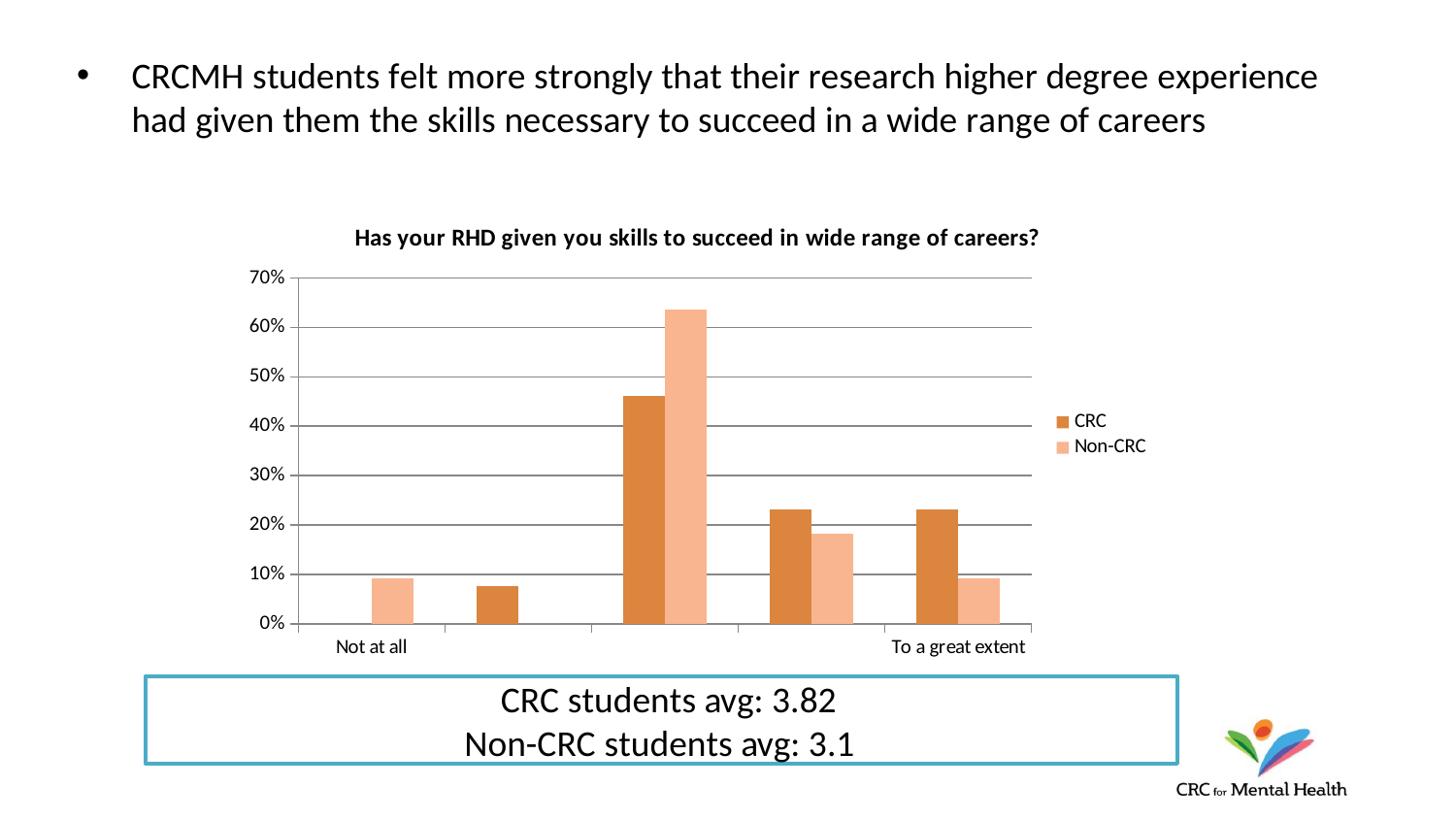
Is the CRC value for 'Not at all' greater or less than 10%? less What kind of chart is shown on the slide? bar chart For 'Not at all', which series has the larger value, CRC or Non-CRC? Non-CRC How many series does the legend list? 2 For 'To a great extent', which series has the larger value, CRC or Non-CRC? CRC Is the CRC value for 'To a great extent' greater or less than 20%? greater Is the Non-CRC value for 'To a great extent' greater or less than 20%? less Which series has the tallest bar anywhere on the chart? Non-CRC How many categories are shown along the x axis of the chart? 5 What is the title of the chart? Has your RHD given you skills to succeed in wide range of careers? What are the two series named in the legend? CRC and Non-CRC